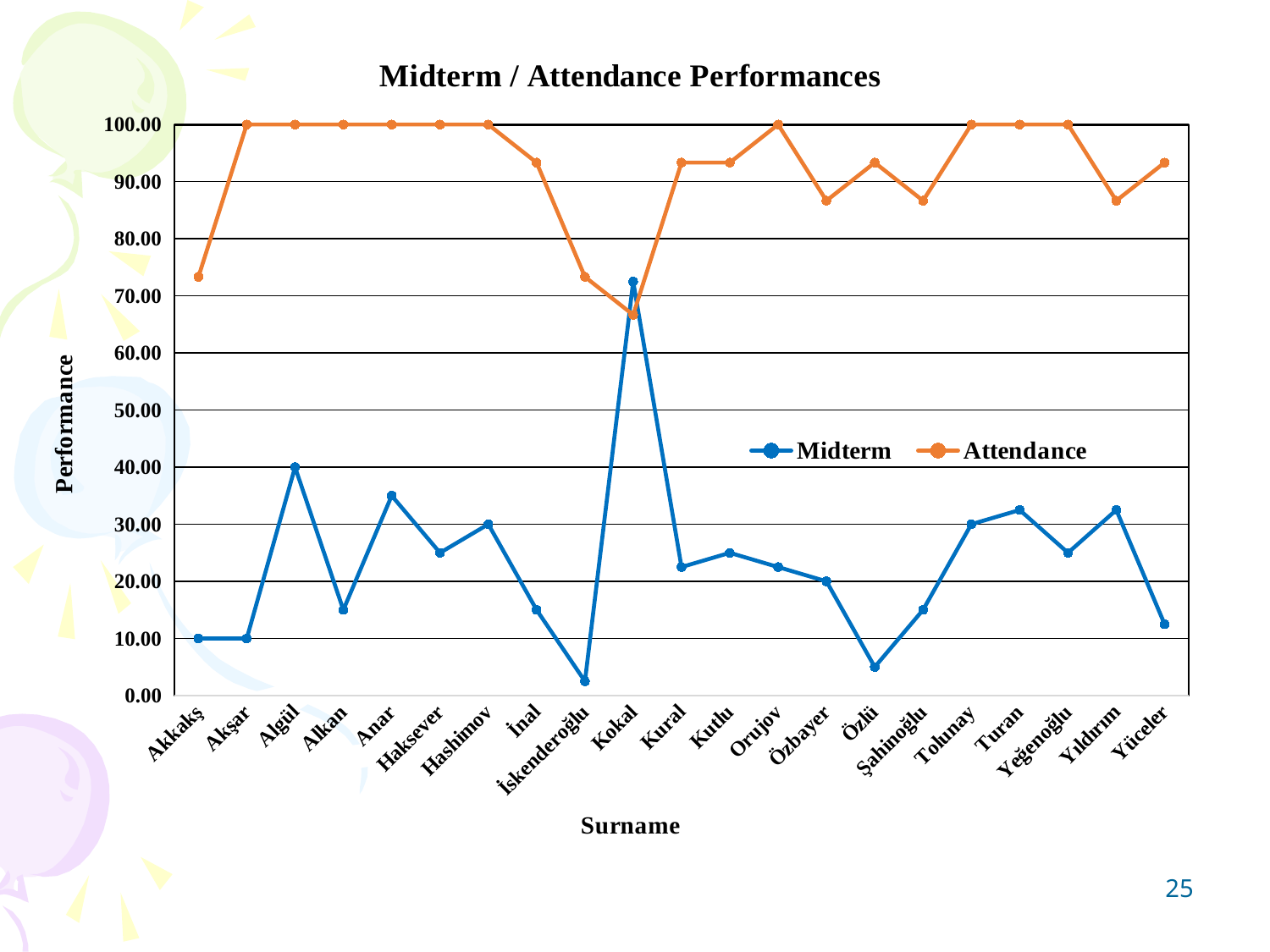
Is the Attendance value for Akkakş greater or less than 80.00? less What is the Midterm value for Akkakş? 10.00 What is the title of the chart? Midterm / Attendance Performances Which is larger, the Midterm value for Algül or the Midterm value for Anar? Algül Which surname has the lowest Midterm value? İskenderoğlu What is the Midterm value for Algül? 40.00 Which surname has the highest Midterm value? Kokal What is the Attendance value for Algül? 100.00 How many surnames are plotted along the x axis? 21 What kind of chart is shown on the slide? line chart Is the Midterm value for Kokal greater or less than 60.00? greater How many series does the legend list? 2